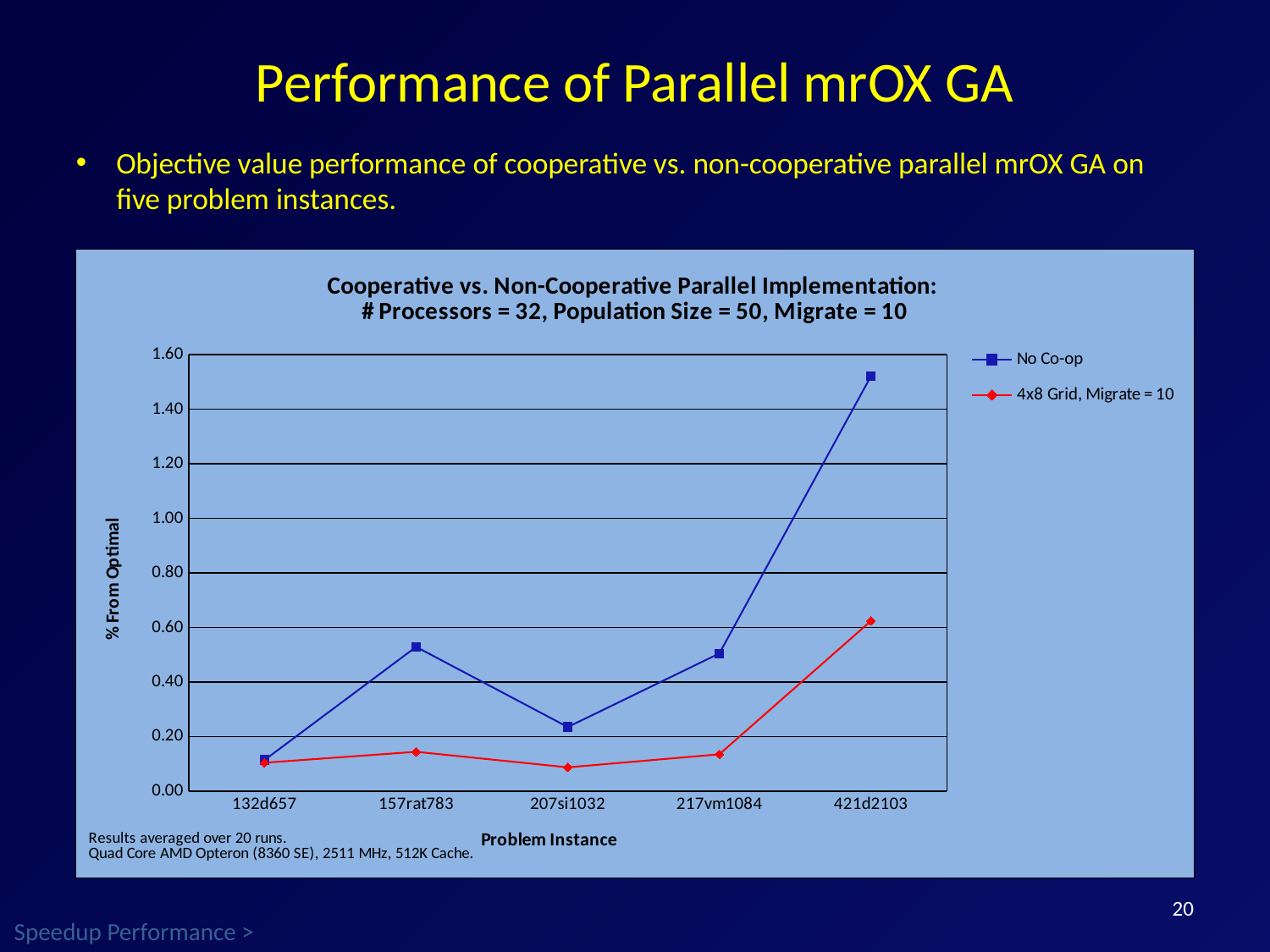
Is the 4x8 Grid, Migrate = 10 value for 421d2103 greater or less than 0.40? greater For which problem instance is the No Co-op series highest? 421d2103 For which problem instance is the No Co-op series lowest? 132d657 For which problem instance is the 4x8 Grid, Migrate = 10 series highest? 421d2103 Is the No Co-op value for 157rat783 greater or less than 0.40? greater How many series does the legend list? 2 Is the No Co-op value for 421d2103 greater or less than 1.40? greater How many problem instances are plotted on the x axis? 5 At 421d2103, which series has the larger % From Optimal: No Co-op or 4x8 Grid, Migrate = 10? No Co-op What type of chart is shown on the slide? line chart What is the label of the y axis? % From Optimal